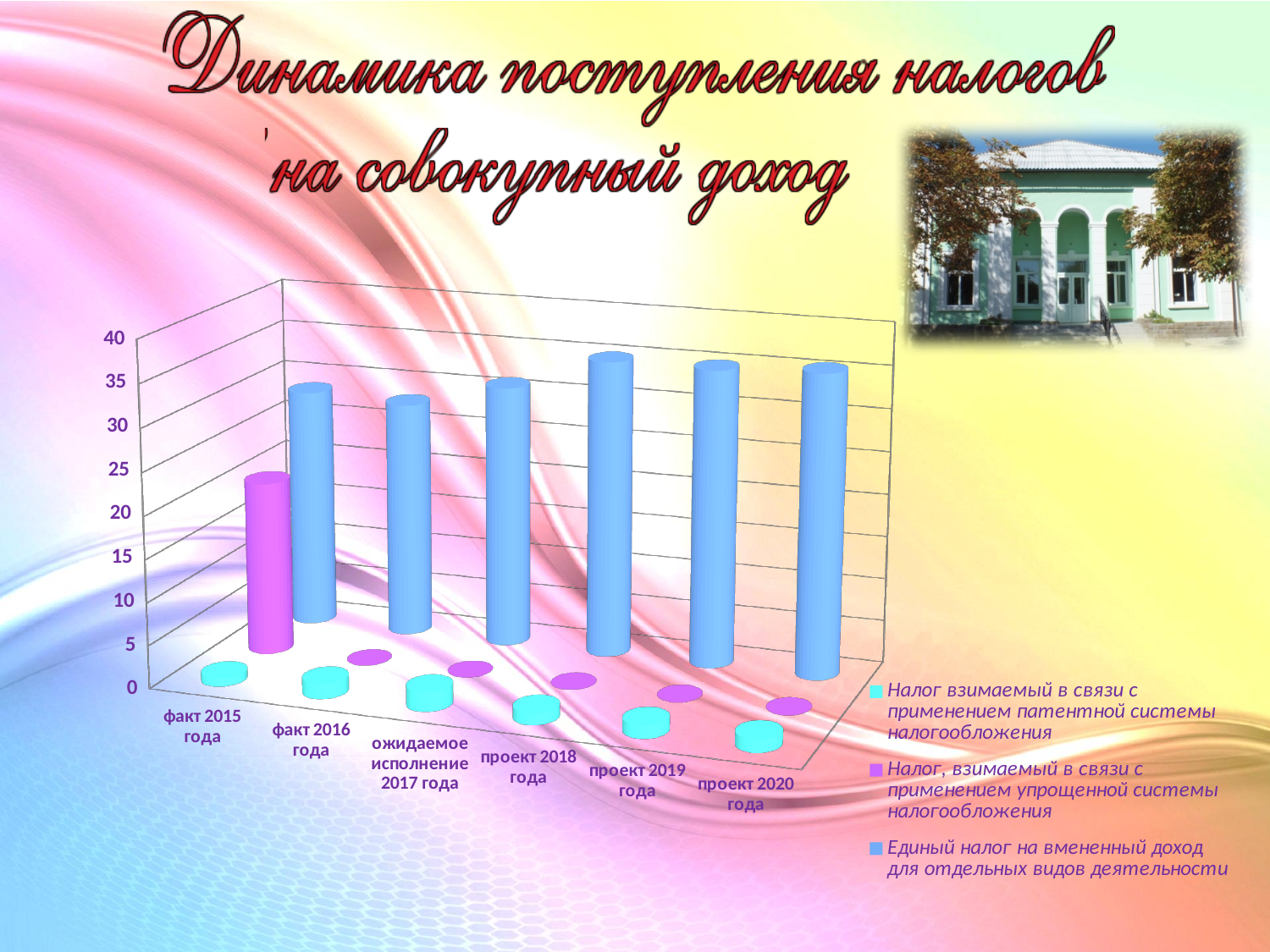
What kind of chart is shown on the slide? bar chart For 'Налог, взимаемый в связи с применением упрощенной системы налогообложения', which is larger: the value for 'факт 2015 года' or for 'факт 2016 года'? факт 2015 года Is the value of 'Налог взимаемый в связи с применением патентной системы налогообложения' for 'проект 2020 года' greater or less than 5? less Is the value of 'Единый налог на вмененный доход для отдельных видов деятельности' for 'факт 2016 года' greater or less than 20? greater What is the title of the chart on the slide? Динамика поступления налогов на совокупный доход Which colour represents 'Единый налог на вмененный доход для отдельных видов деятельности' in the chart? blue Is the value of 'Налог, взимаемый в связи с применением упрощенной системы налогообложения' for 'проект 2019 года' greater or less than 5? less Does the value of 'Налог, взимаемый в связи с применением упрощенной системы налогообложения' rise or fall from 'факт 2015 года' to 'факт 2016 года'? fall How many series does the chart legend list? 3 How many categories are shown along the x axis of the chart? 6 For 'факт 2015 года', which series has the larger value: 'Единый налог на вмененный доход для отдельных видов деятельности' or 'Налог, взимаемый в связи с применением упрощенной системы налогообложения'? Единый налог на вмененный доход для отдельных видов деятельности